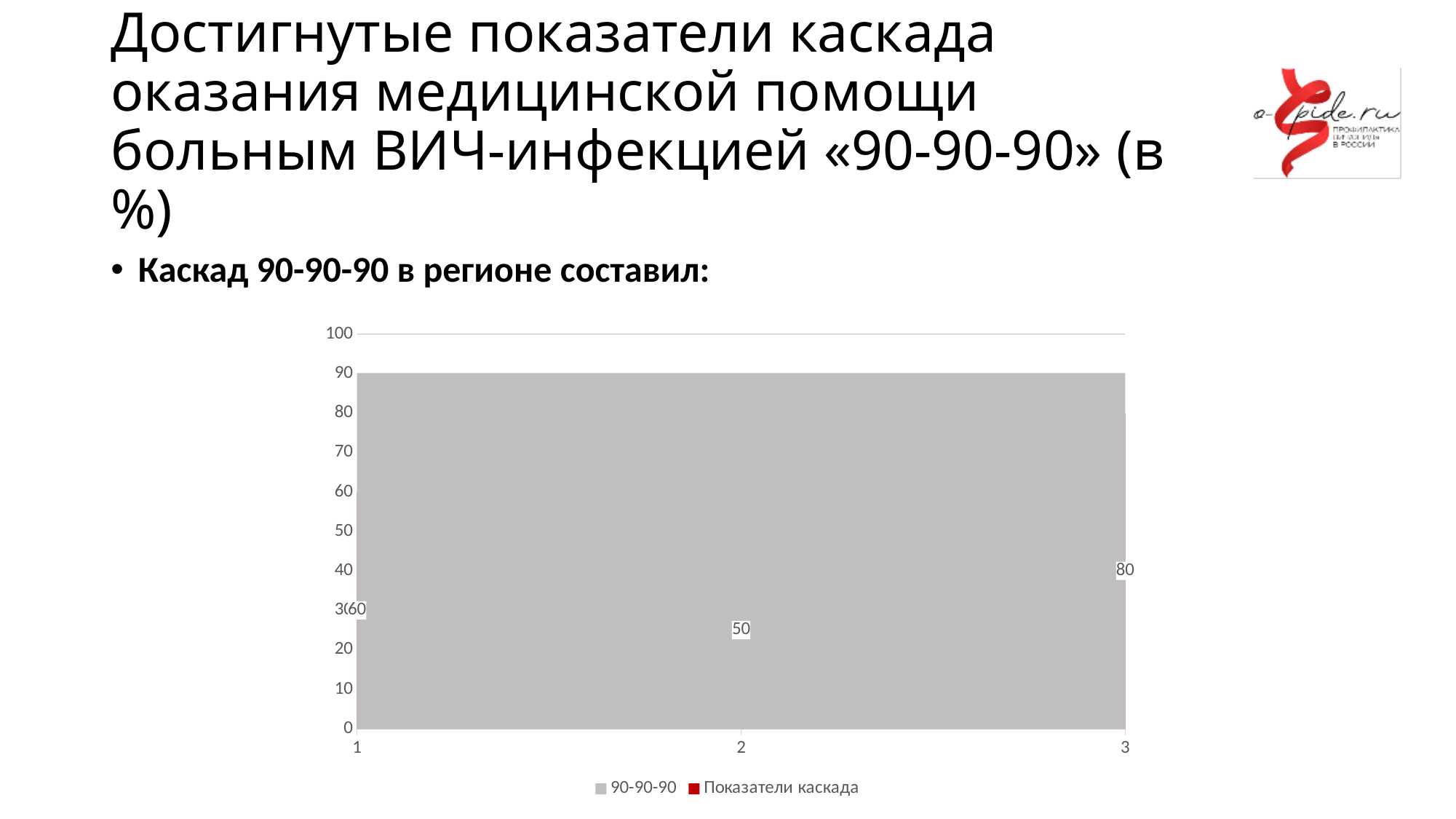
What is the value of the 'Показатели каскада' series at category 3? 80 What are the two series names listed in the legend? 90-90-90 and Показатели каскада Which is larger for the 'Показатели каскада' series: the value at category 1 or at category 3? category 3 What is the value of the 'Показатели каскада' series at category 1? 60 At which category is the 'Показатели каскада' series lowest? 2 What is the value of the 'Показатели каскада' series at category 2? 50 How many categories are shown on the x axis? 3 What kind of chart is shown on the slide? area chart How many series does the legend list? 2 At which category is the 'Показатели каскада' series highest? 3 What is the difference between the 'Показатели каскада' values at category 3 and category 2? 30 Is the value of the '90-90-90' series at category 2 greater or less than 80? greater